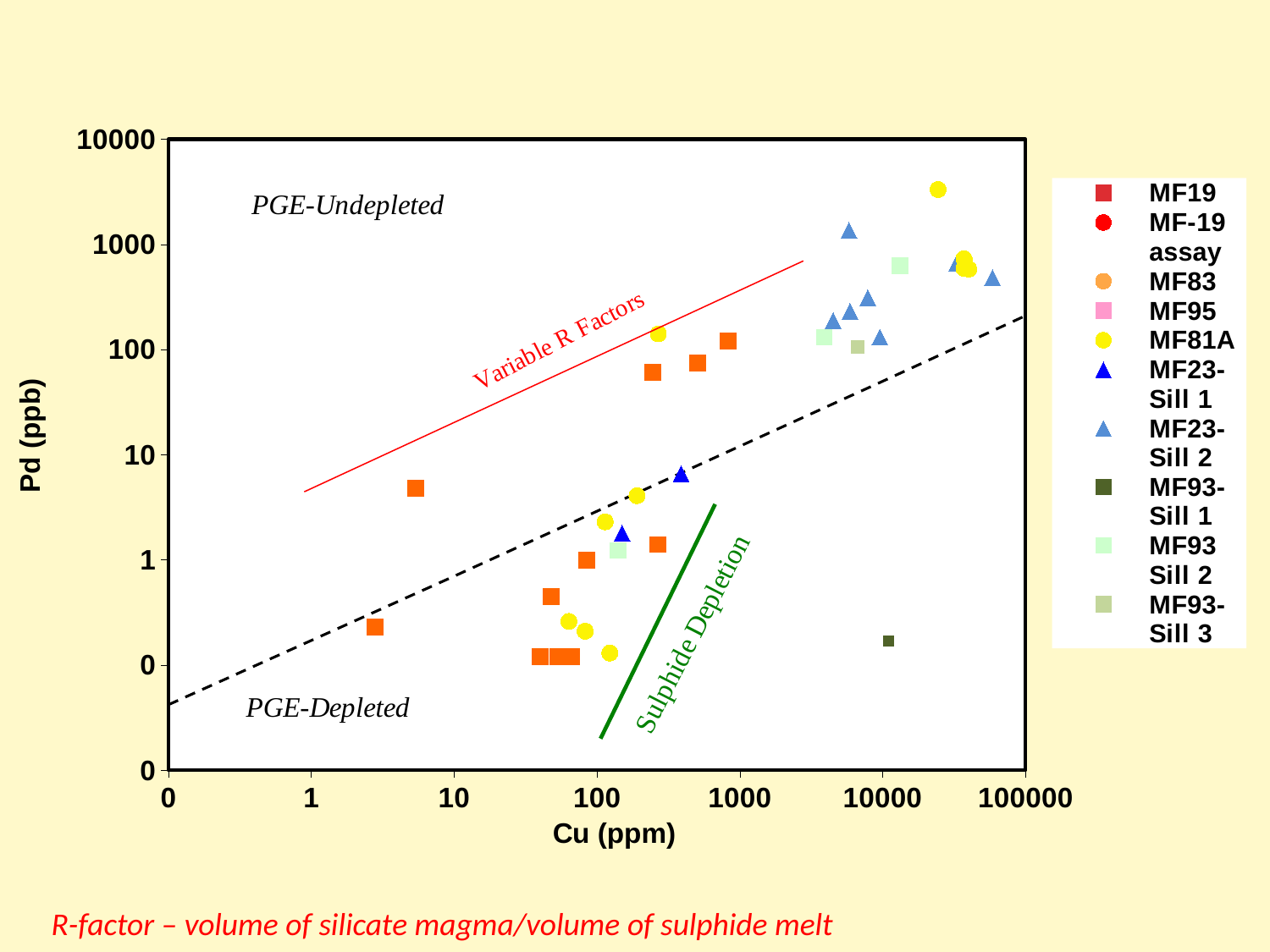
How many series does the legend list? 10 Is the Pd (ppb) value of the highest MF81A point greater or less than 1000? greater What kind of chart is shown on the slide? scatter chart What is the label of the x axis? Cu (ppm) Are the Pd (ppb) values of the MF23-Sill 1 points greater or less than 10? less Is the Cu (ppm) value of the MF23-Sill 2 point with the highest Pd greater or less than 1000? greater What is the label of the y axis? Pd (ppb) Which series has the point with the highest Pd (ppb) value? MF81A